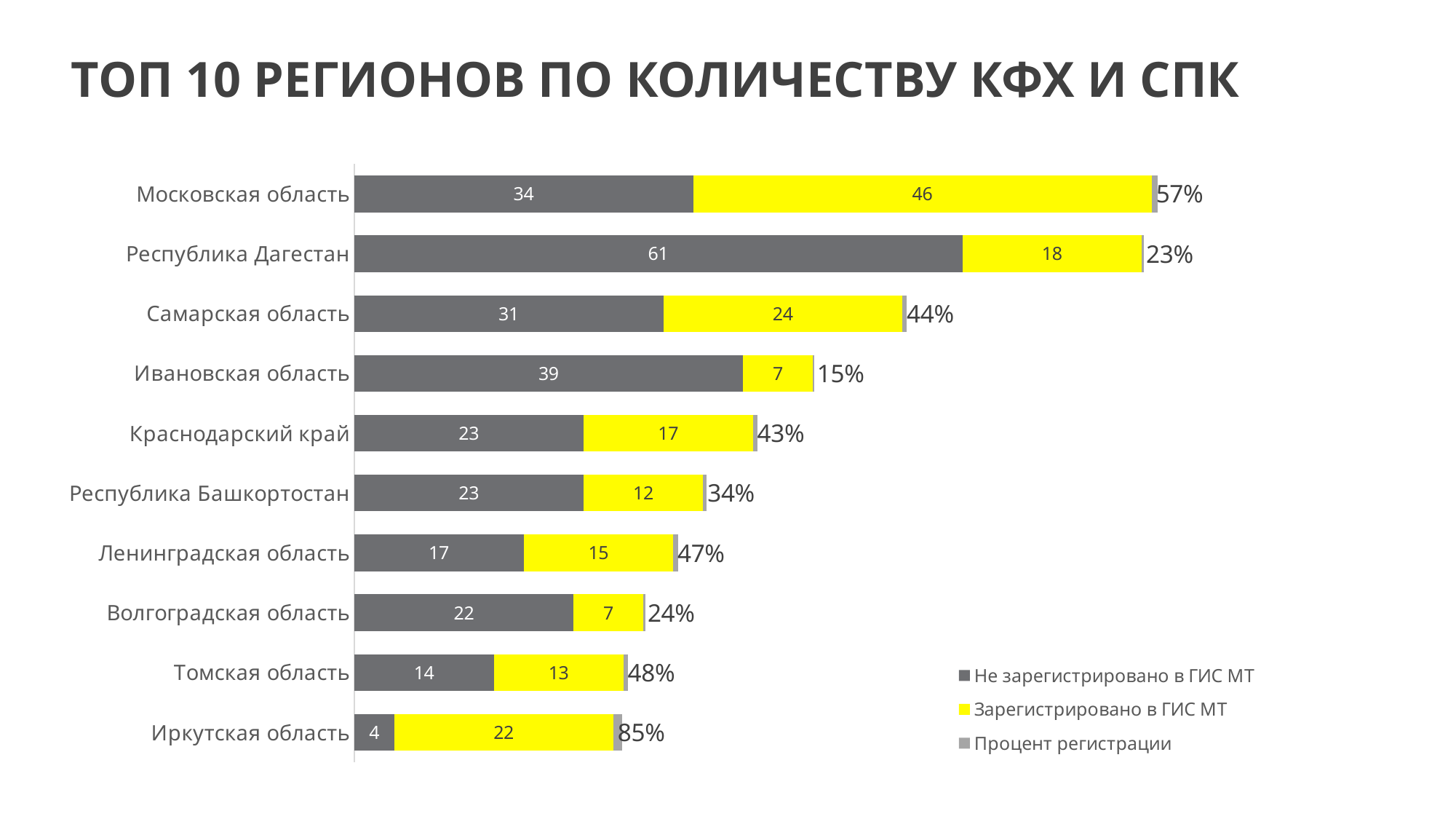
What is the 'Процент регистрации' for Иркутская область? 85% What colour represents the 'Зарегистрировано в ГИС МТ' series? Yellow How many regions are shown on the chart? 10 Which region has the lowest 'Процент регистрации'? Ивановская область What kind of chart is shown on the slide? Stacked bar chart What is the difference between the 'Зарегистрировано в ГИС МТ' values for Московская область and Самарская область? 22 Which region has the highest 'Не зарегистрировано в ГИС МТ' value? Республика Дагестан How many series does the legend list? 3 Which is larger: the 'Зарегистрировано в ГИС МТ' value for Краснодарский край or for Республика Башкортостан? Краснодарский край What is the value of 'Зарегистрировано в ГИС МТ' for Московская область? 46 What is the value of 'Не зарегистрировано в ГИС МТ' for Республика Дагестан? 61 What is the total of the 'Не зарегистрировано в ГИС МТ' and 'Зарегистрировано в ГИС МТ' segments for Томская область? 27